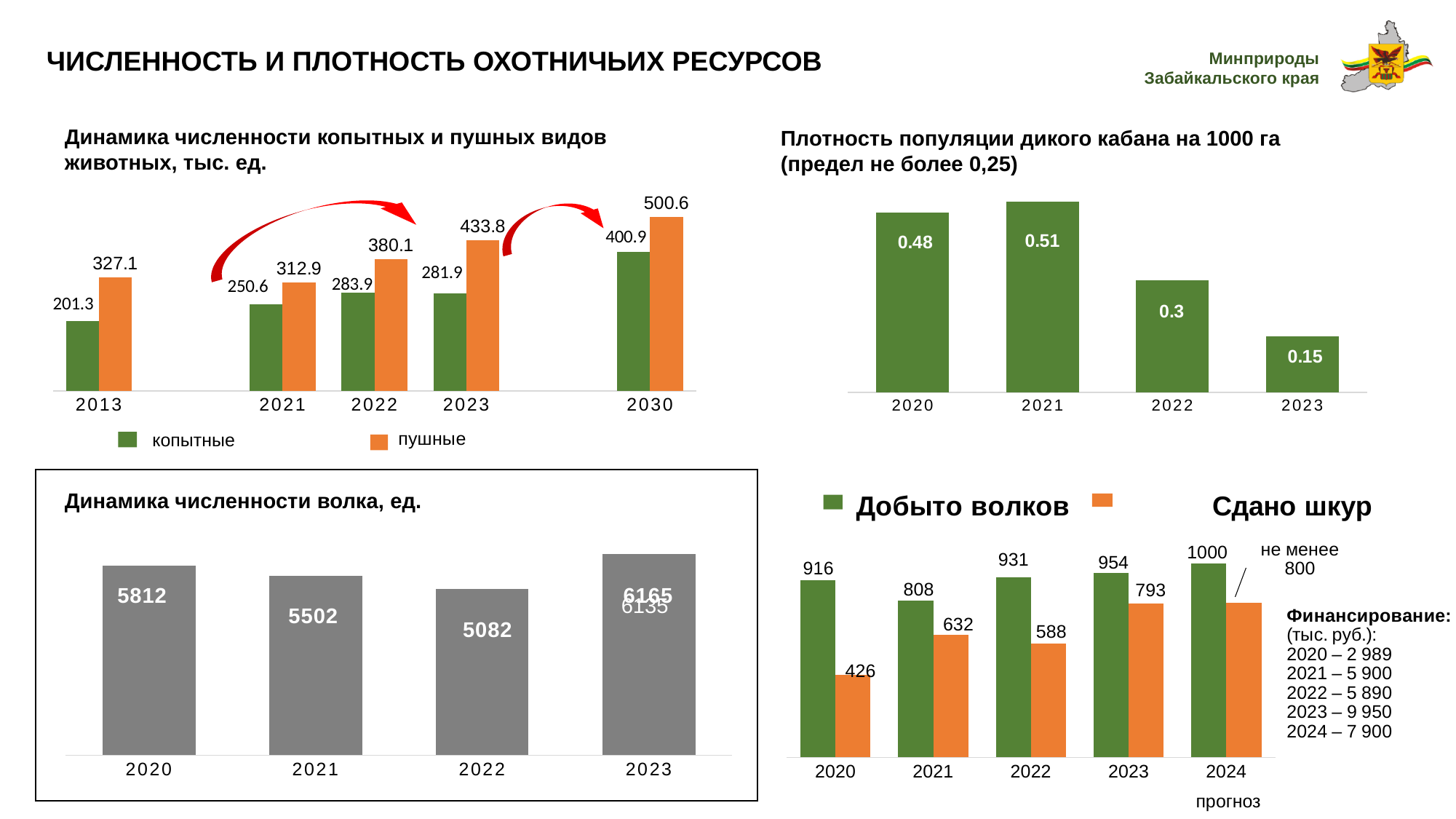
In the chart 'Плотность популяции дикого кабана на 1000 га', what is the value for 2023? 0.15 In the chart 'Плотность популяции дикого кабана на 1000 га', do the values rise or fall from 2021 to 2023? fall In the bottom-right chart with series 'Добыто волков' and 'Сдано шкур', what is the difference between Добыто волков and Сдано шкур in 2023? 161 In the bottom-right chart with series 'Добыто волков' and 'Сдано шкур', what is the value for Сдано шкур in 2020? 426 What kind of chart is 'Динамика численности волка, ед.'? bar chart In the chart 'Динамика численности копытных и пушных видов животных, тыс. ед.', what is the value for копытные in 2013? 201.3 In the chart 'Динамика численности волка, ед.', what is the value for 2021? 5502 In the chart 'Динамика численности волка, ед.', which year has the lowest value? 2022 In the chart 'Динамика численности копытных и пушных видов животных, тыс. ед.', what is the value for пушные in 2023? 433.8 In the chart 'Плотность популяции дикого кабана на 1000 га', which year has the highest value? 2021 In the chart 'Динамика численности копытных и пушных видов животных, тыс. ед.', what is the difference between пушные and копытные in 2030? 99.7 How many series does the legend of the chart 'Динамика численности копытных и пушных видов животных, тыс. ед.' list? 2